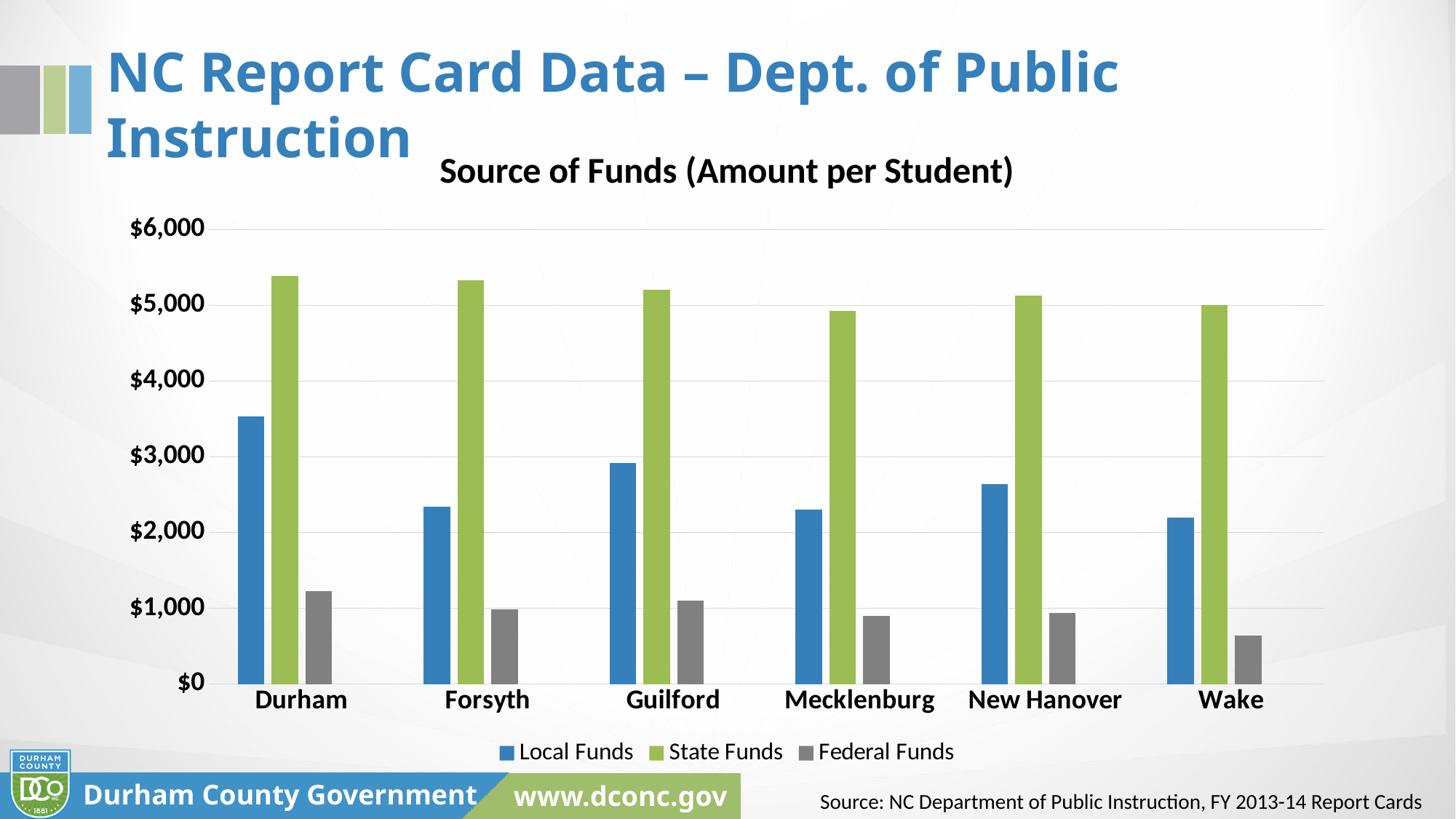
Is the Local Funds value for Durham greater or less than $3,000? greater What kind of chart is shown on the slide? bar chart How many counties are shown on the x axis? 6 Which is larger, the Local Funds value for Durham or for Guilford? Durham How many series does the legend list? 3 Which is larger, the Local Funds value for New Hanover or for Forsyth? New Hanover What is the title of the chart? Source of Funds (Amount per Student) Which county has the highest Local Funds amount per student? Durham Which county has the lowest Federal Funds amount per student? Wake Which county has the highest Federal Funds amount per student? Durham Is the Federal Funds value for Wake greater or less than $1,000? less Is the State Funds value for Guilford greater or less than $5,000? greater